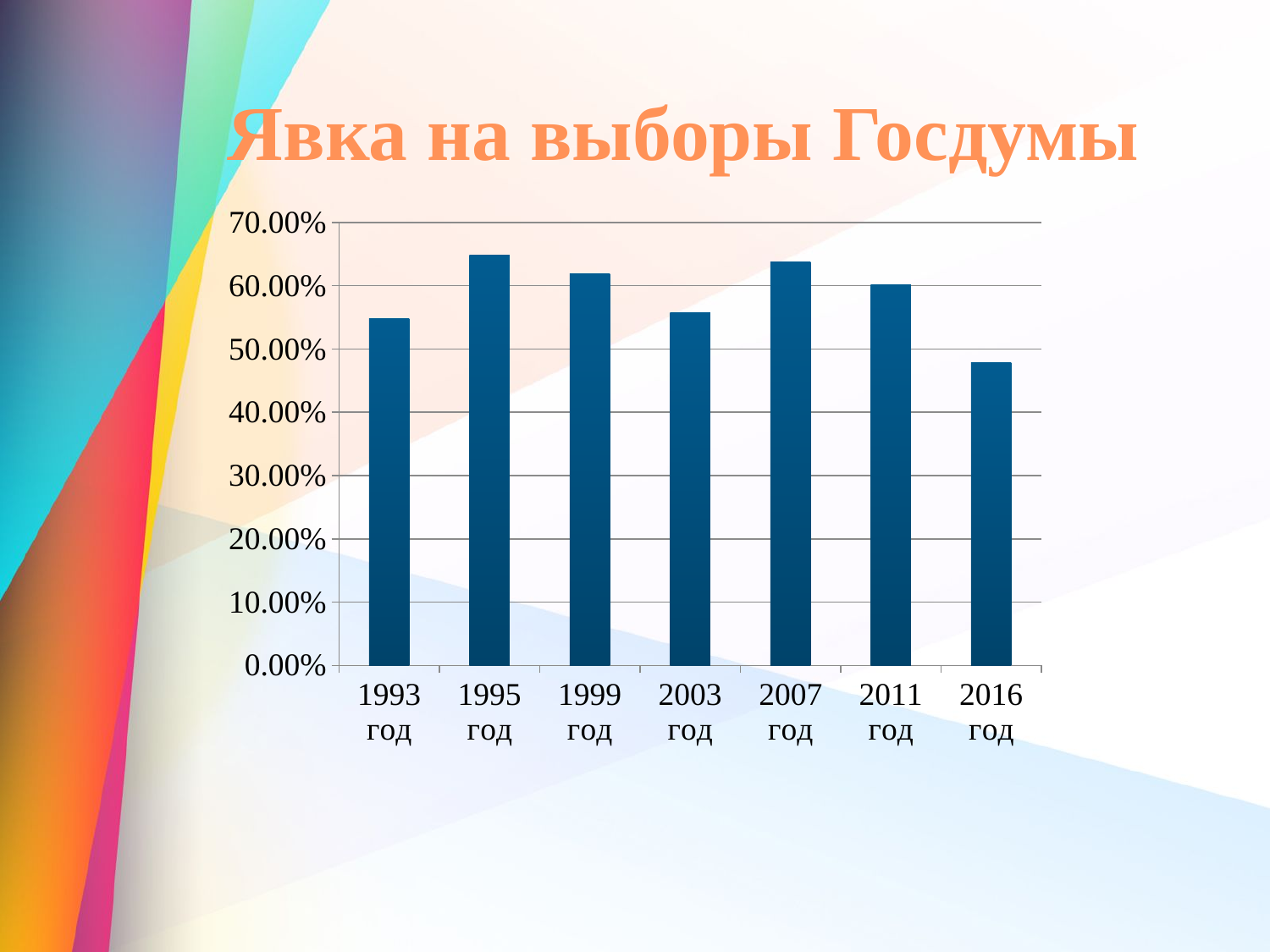
Which year has the highest turnout in the chart? 1995 год What kind of chart is shown on the slide? bar chart Which is larger, the value for 1995 год or the value for 1999 год? 1995 год Which year has the lowest turnout in the chart? 2016 год Is the value for 2003 год greater or less than 60.00%? less Is the value for 2016 год greater or less than 50.00%? less How many years (bars) are shown in the chart? 7 Is the value for 1993 год greater or less than 50.00%? greater Which is larger, the value for 2007 год or the value for 2011 год? 2007 год What is the title of the slide? Явка на выборы Госдумы Do the values rise or fall from 2007 год to 2016 год? fall